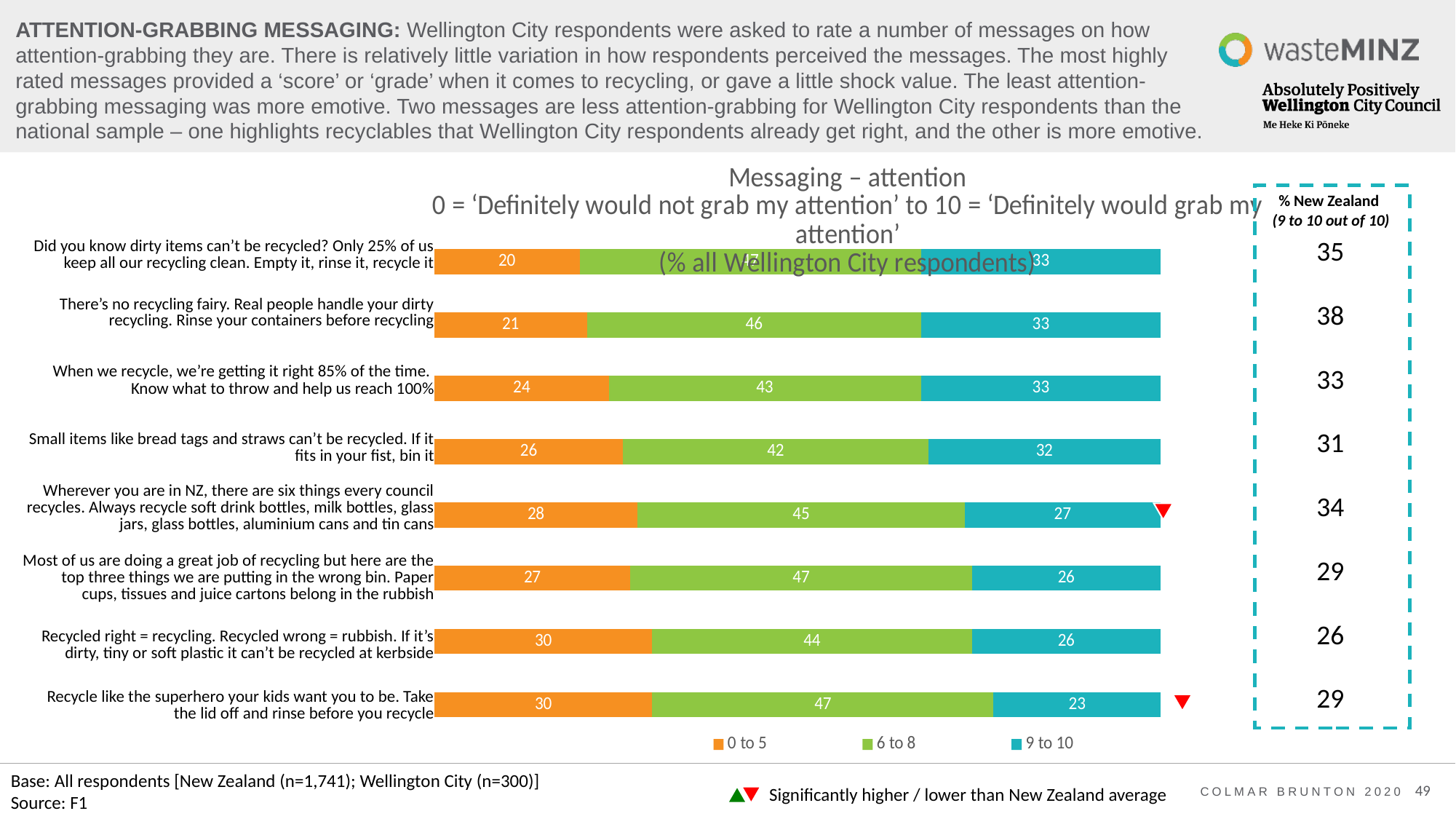
What kind of chart is shown on the slide? Stacked bar chart What percentage of Wellington City respondents rated the message 'Recycle like the superhero your kids want you to be. Take the lid off and rinse before you recycle' 9 to 10? 23 How many messages (categories) are plotted in the chart? 8 Which message has the lowest '9 to 10' percentage among Wellington City respondents? Recycle like the superhero your kids want you to be. Take the lid off and rinse before you recycle What are the three series listed in the chart legend? 0 to 5, 6 to 8, 9 to 10 What is the '0 to 5' value for the message 'When we recycle, we're getting it right 85% of the time. Know what to throw and help us reach 100%'? 24 What percentage of Wellington City respondents rated the message 'There's no recycling fairy. Real people handle your dirty recycling. Rinse your containers before recycling' 6 to 8? 46 How many series does the chart legend list? 3 Which message has the lowest '0 to 5' percentage among Wellington City respondents? Did you know dirty items can't be recycled? Only 25% of us keep all our recycling clean. Empty it, rinse it, recycle it Which is larger: the '0 to 5' value for 'Small items like bread tags and straws can't be recycled...' or for 'Recycled right = recycling. Recycled wrong = rubbish...'? Recycled right = recycling. Recycled wrong = rubbish... What is the difference between the '9 to 10' value for 'There's no recycling fairy...' (33) and for 'Recycle like the superhero...' (23)? 10 What is the total of the three segments for the message 'Wherever you are in NZ, there are six things every council recycles...'? 100